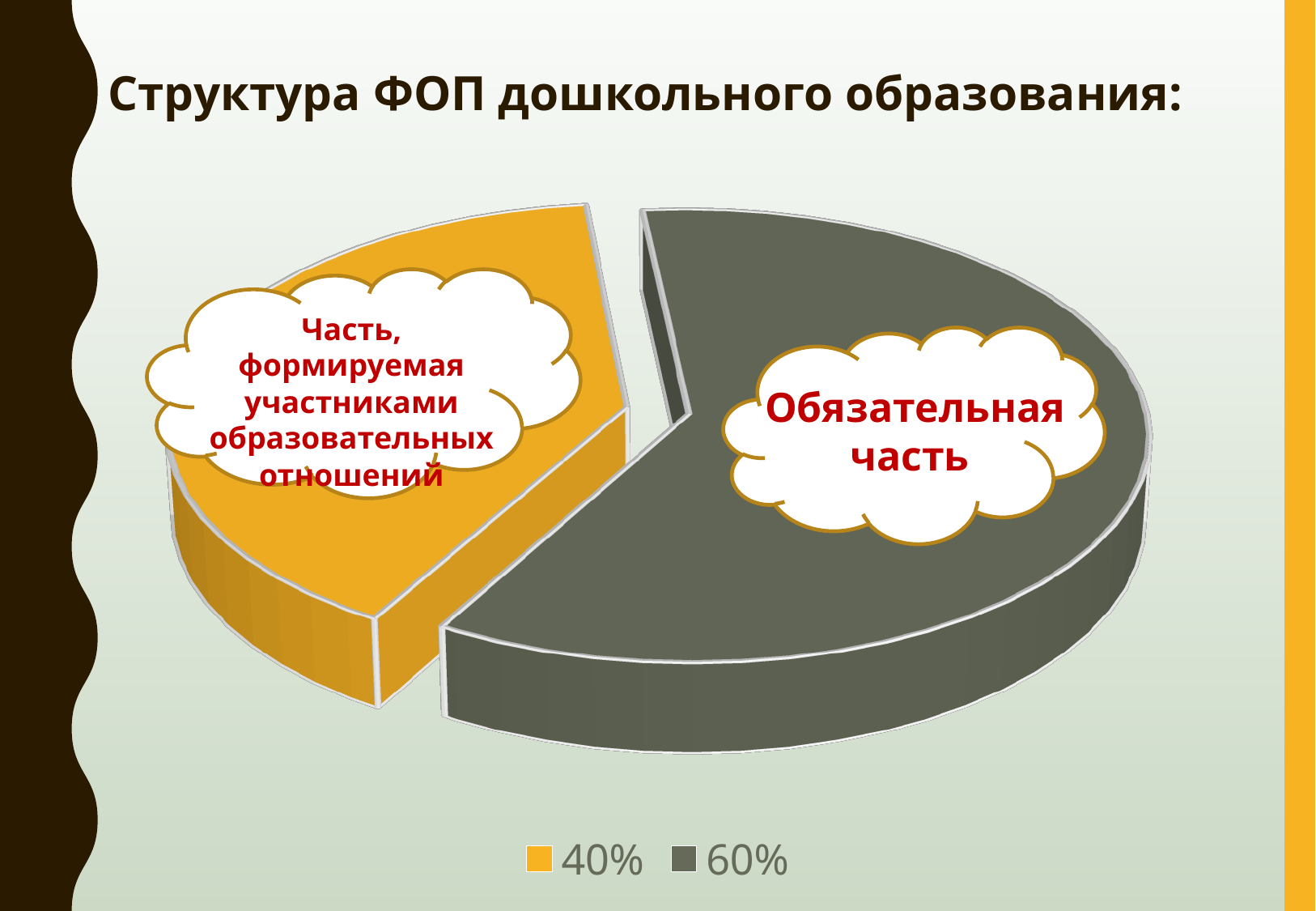
What share of the pie does the orange slice labelled "Часть, формируемая участниками образовательных отношений" represent? 40% What kind of chart is shown on the slide? pie chart Which is larger: the slice for "Обязательная часть" or the slice for "Часть, формируемая участниками образовательных отношений"? Обязательная часть What is the title of the slide containing the pie chart? Структура ФОП дошкольного образования: Which slice of the pie chart is the smallest? Часть, формируемая участниками образовательных отношений What is the difference in percentage points between the 60% slice and the 40% slice? 20% What colour is the slice labelled "Обязательная часть" in the pie chart? grey What share of the pie does the grey slice labelled "Обязательная часть" represent? 60% What is the total of the two slices shown in the pie chart legend? 100% How many entries does the legend of the pie chart list? 2 Which slice of the pie chart is the largest? Обязательная часть How many slices does the pie chart have? 2